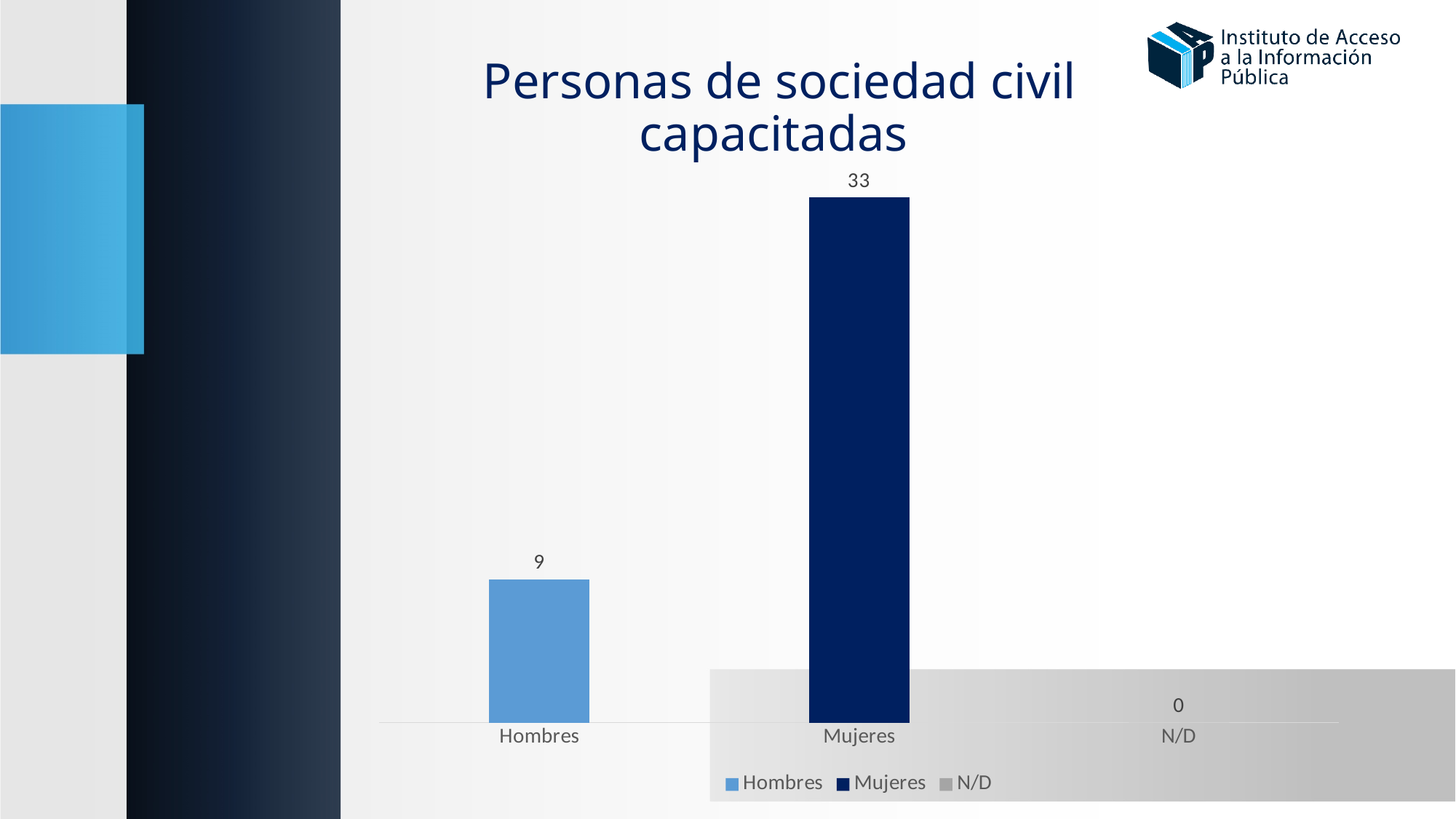
How many entries does the legend list? 3 Which is larger, the value for Hombres or the value for Mujeres? Mujeres What is the value for Hombres? 9 What is the difference between the values for Mujeres and Hombres? 24 Which category has the highest value? Mujeres What is the title of the chart? Personas de sociedad civil capacitadas Which category has the lowest value? N/D What is the value for Mujeres? 33 How many categories are shown on the x axis? 3 What kind of chart is shown on the slide? Bar chart What colour is the bar for Mujeres? Dark blue What is the value for N/D? 0